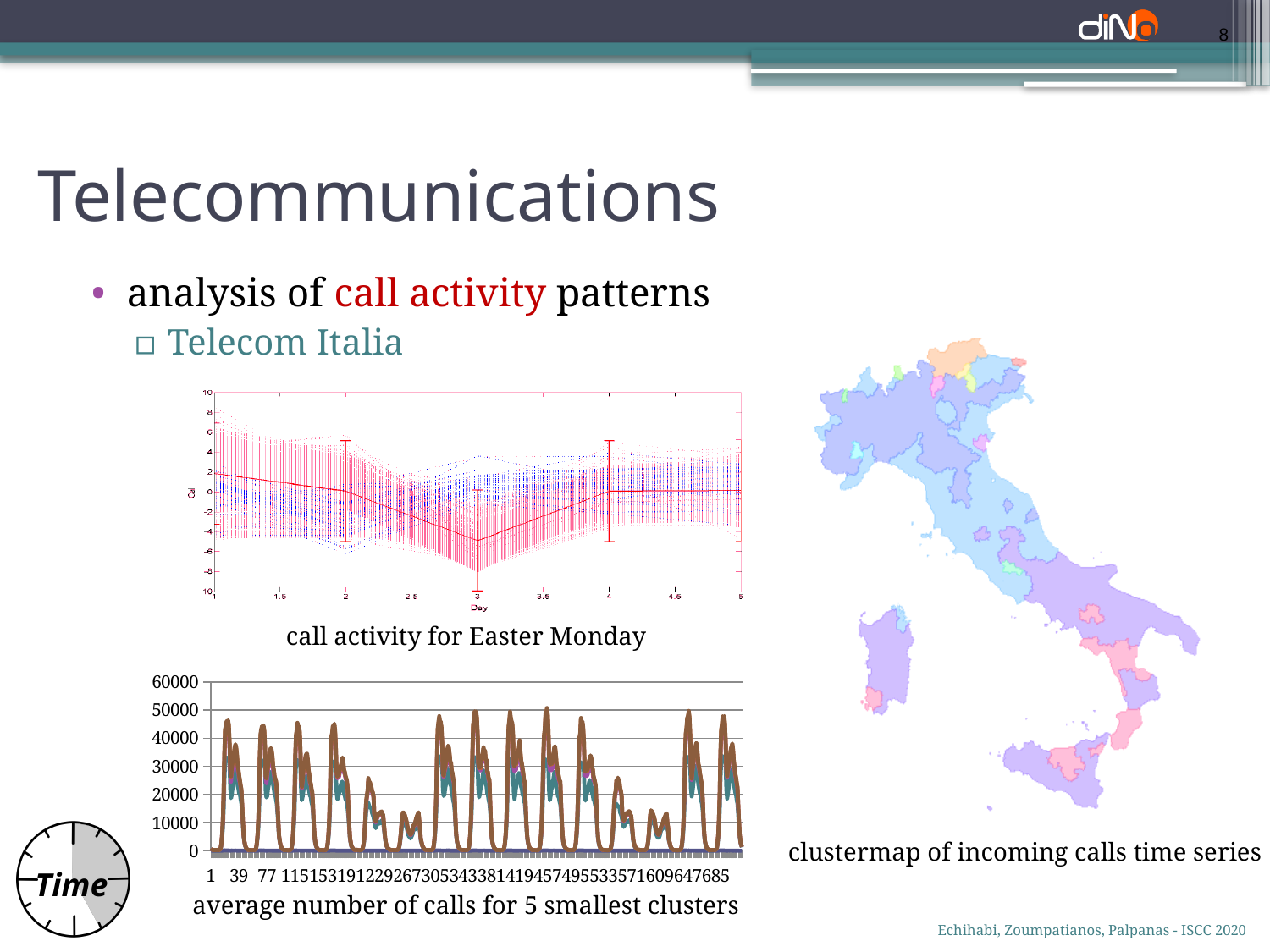
In the 'call activity for Easter Monday' chart, is the red line's value at Day 3 greater or less than 0? less According to its caption, how many clusters are plotted in the 'average number of calls' chart? 5 In the 'average number of calls for 5 smallest clusters' chart, what is the highest value shown on the y axis? 60000 In the 'average number of calls for 5 smallest clusters' chart, are the tallest peaks greater or less than 40000? greater In the 'call activity for Easter Monday' chart, what is the highest value shown on the y axis? 10 What kind of chart is the 'average number of calls for 5 smallest clusters' chart? line chart What kind of chart is the 'call activity for Easter Monday' chart? line chart In the 'average number of calls for 5 smallest clusters' chart, are the tallest peaks greater or less than 60000? less In the 'call activity for Easter Monday' chart, does the red line rise or fall from Day 3 to Day 4? rise In the 'call activity for Easter Monday' chart, at which Day does the red line reach its lowest value? 3 In the 'call activity for Easter Monday' chart, does the red line rise or fall from Day 1 to Day 3? fall In the 'average number of calls for 5 smallest clusters' chart, what is the last label shown on the x axis? 685